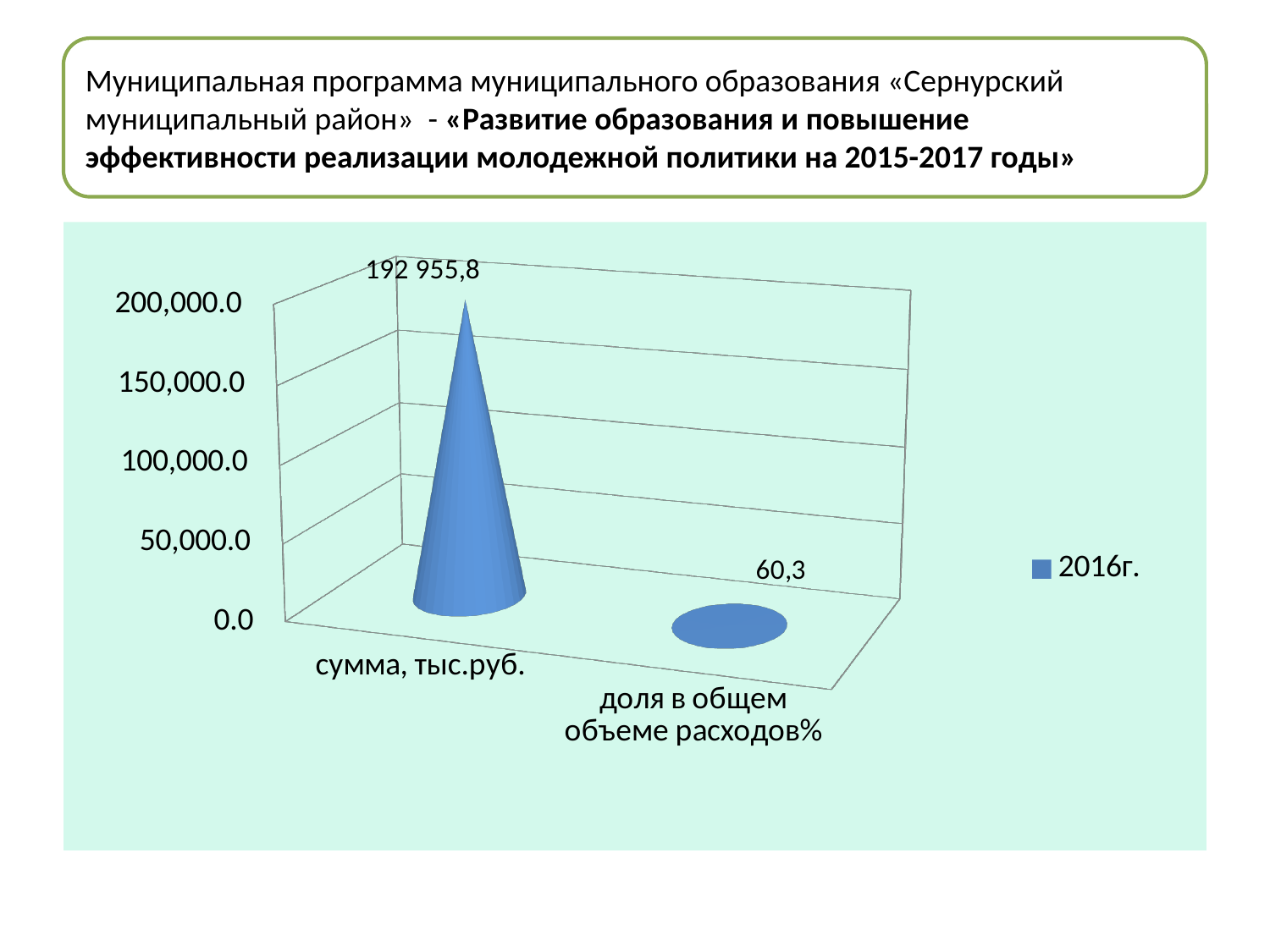
Which is larger: the value for «сумма, тыс.руб.» or the value for «доля в общем объеме расходов%»? сумма, тыс.руб. What is the legend entry of the chart? 2016г. What kind of chart is shown on the slide? bar chart What is the value for «сумма, тыс.руб.»? 192 955,8 How many series does the legend list? 1 Is the value for «доля в общем объеме расходов%» greater or less than 50,000.0? less Which category has the highest value? сумма, тыс.руб. Is the value for «сумма, тыс.руб.» greater or less than 150,000.0? greater How many categories are shown on the chart? 2 What is the value for «доля в общем объеме расходов%»? 60,3 Which category has the lowest value? доля в общем объеме расходов% What is the highest value shown on the vertical axis? 200,000.0